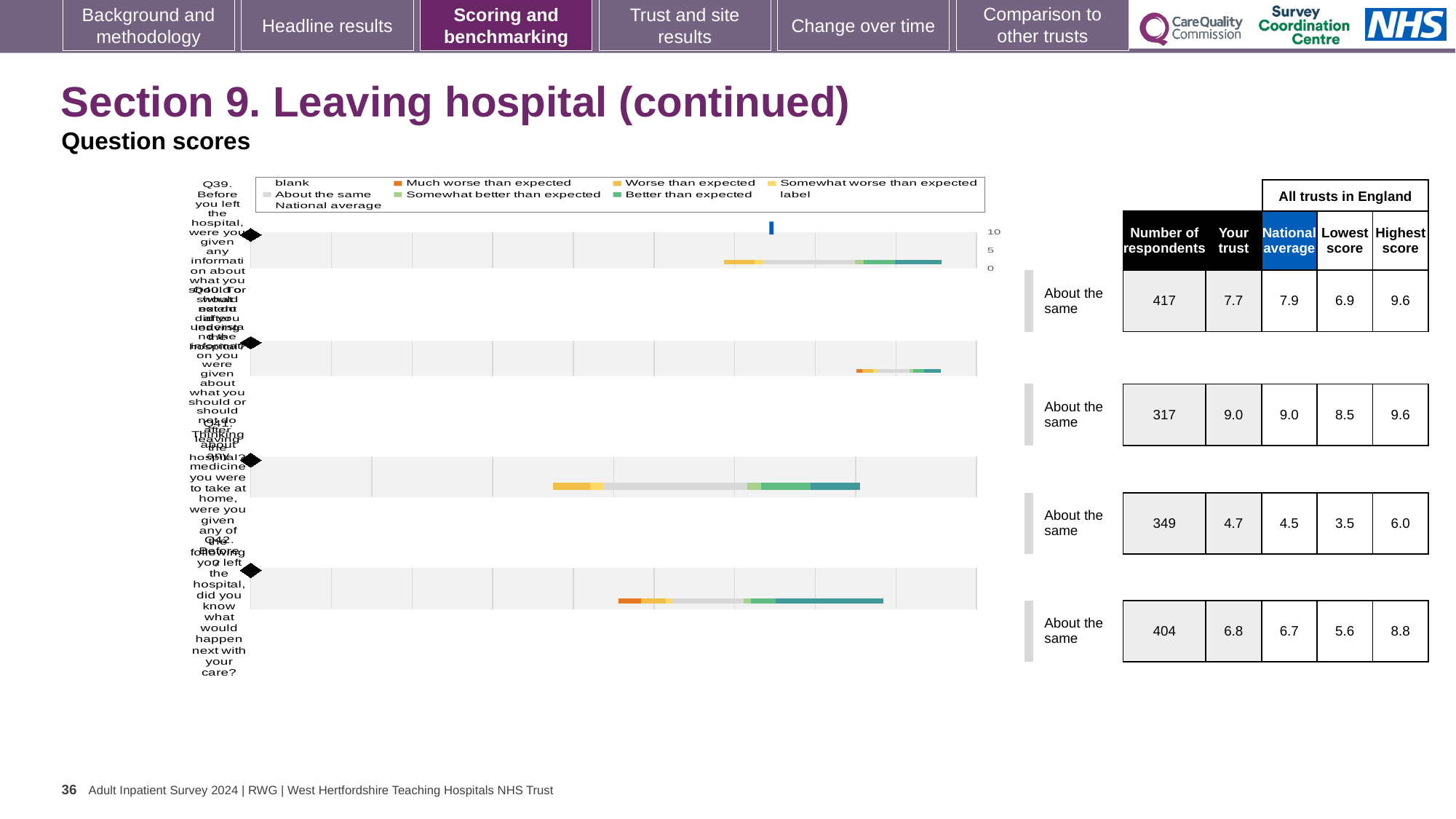
Which question has the fewest respondents in the table beside the chart? Q40 Which question has the highest 'Your trust' score in the table beside the chart? Q40 For Q39, which is larger: the 'Your trust' score or the national average? National average According to the table beside the chart, what is the highest score in England for Q40? 9.6 According to the table beside the chart, what is the national average for Q41? 4.5 For Q41, what is the difference between the highest score and the lowest score in England? 2.5 How many questions (Q39 to Q42) are plotted in the chart? 4 What kind of chart is used to show the question scores on this slide? bar chart What benchmark category is shown next to each of the four questions in the chart? About the same According to the table beside the chart, how many respondents answered Q42? 404 According to the table beside the chart, what is the 'Your trust' score for Q39? 7.7 Which question has the lowest 'Your trust' score in the table beside the chart? Q41